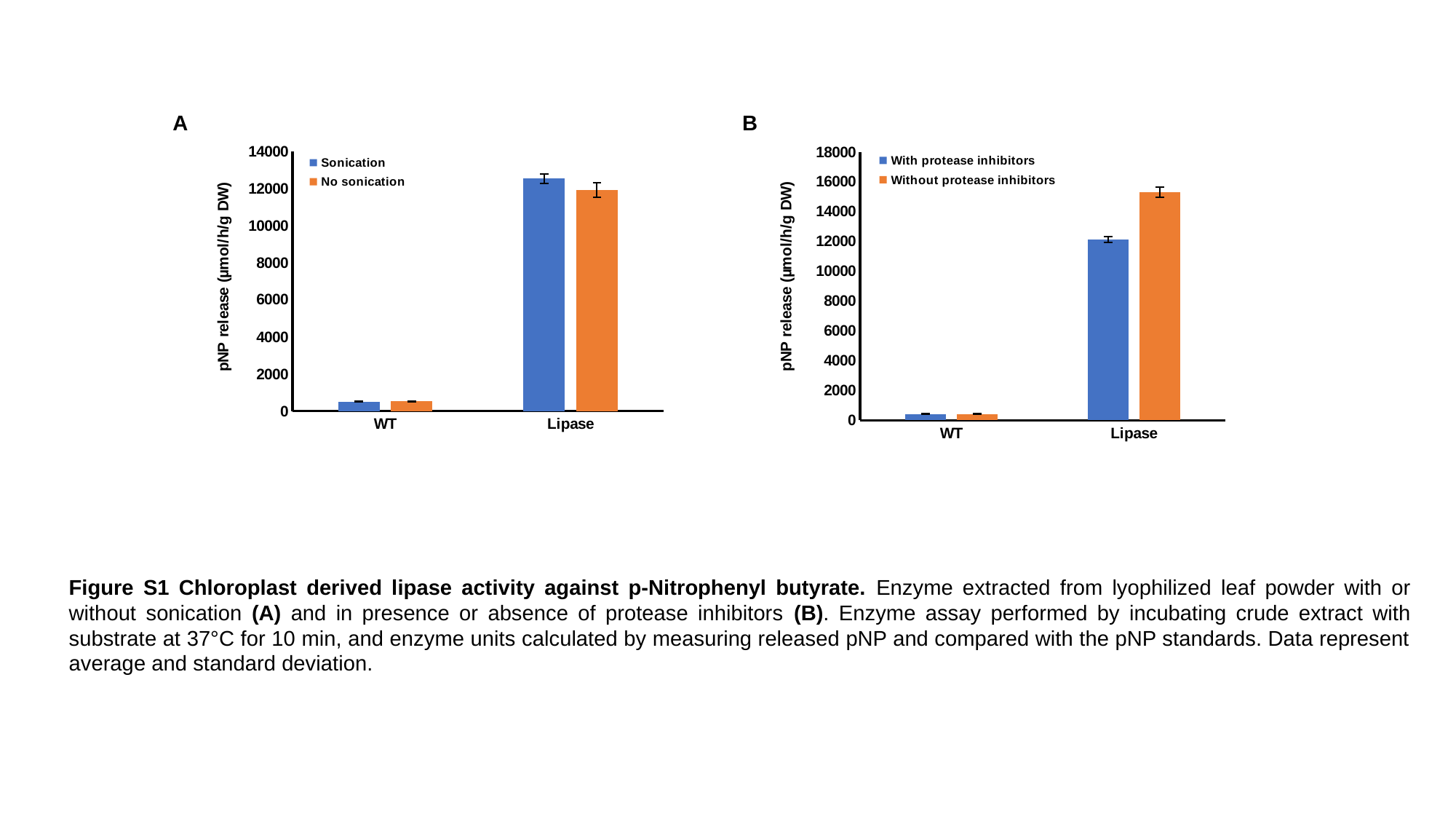
In chart A, which category has the lower values, WT or Lipase? WT In chart B, which is larger for Lipase: With protease inhibitors or Without protease inhibitors? Without protease inhibitors What is the y-axis title of chart A? pNP release (µmol/h/g DW) In chart A, is the value for WT with No sonication greater or less than 2000? less What kind of chart is chart A? bar chart In chart B, is the value for Lipase Without protease inhibitors greater or less than 14000? greater How many series does the legend of chart A list? 2 How many categories are shown on the x axis of chart B? 2 What are the two legend entries in chart B? With protease inhibitors; Without protease inhibitors In chart B, which bar is the highest? Lipase, Without protease inhibitors In chart A, is the value for Lipase with Sonication greater or less than 12000? greater